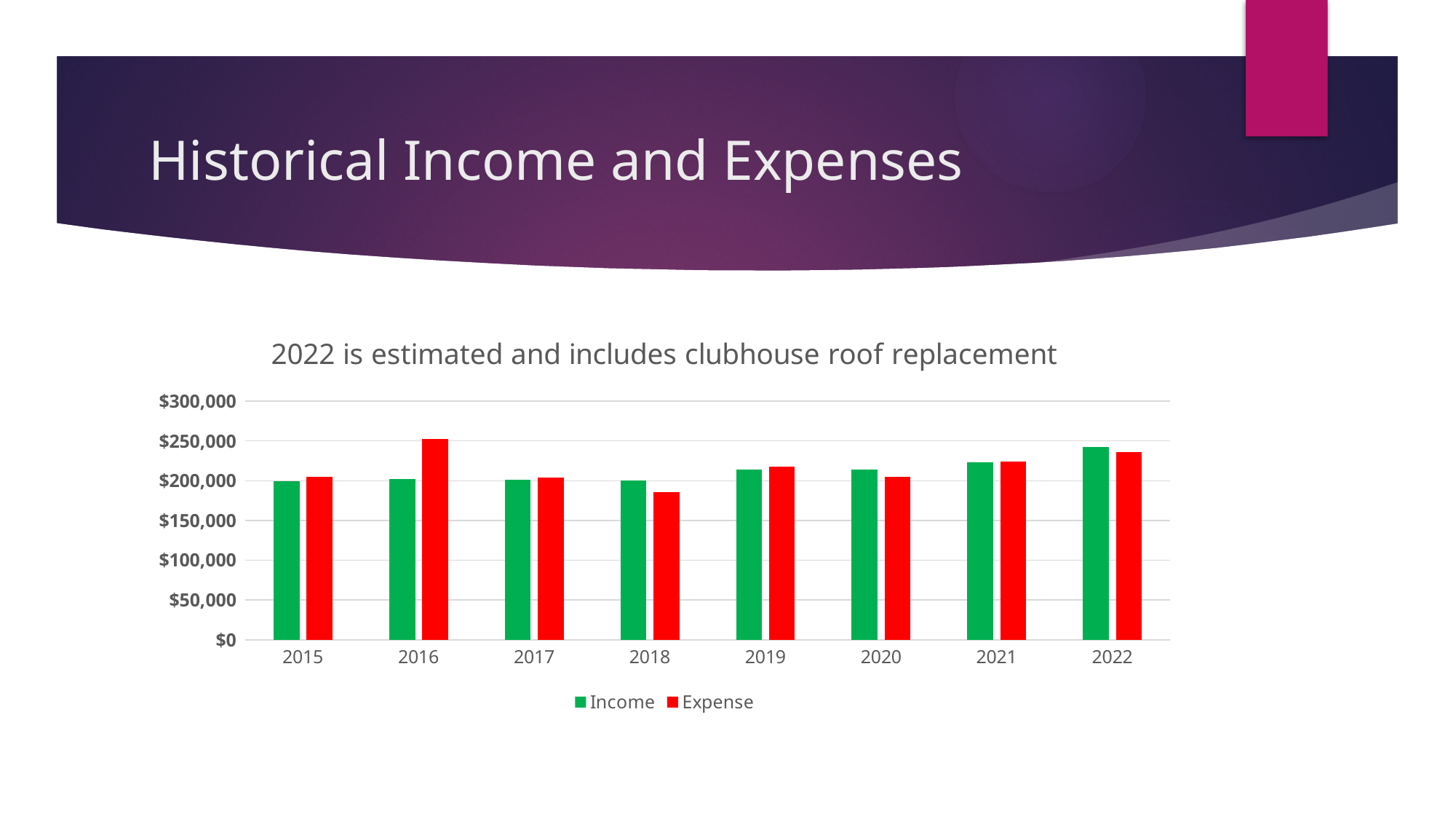
In which year is Expense highest? 2016 Is the Expense value for 2018 greater or less than $200,000? less In 2018, which is larger, Income or Expense? Income In which year is Income highest? 2022 In which year is Expense lowest? 2018 How many years are shown on the x axis? 8 In 2016, which is larger, Income or Expense? Expense Is the Income value for 2022 greater or less than $200,000? greater Does Income rise or fall from 2019 to 2022? rise What colour are the Expense bars? red What kind of chart is shown on the slide? bar chart How many series does the legend list? 2